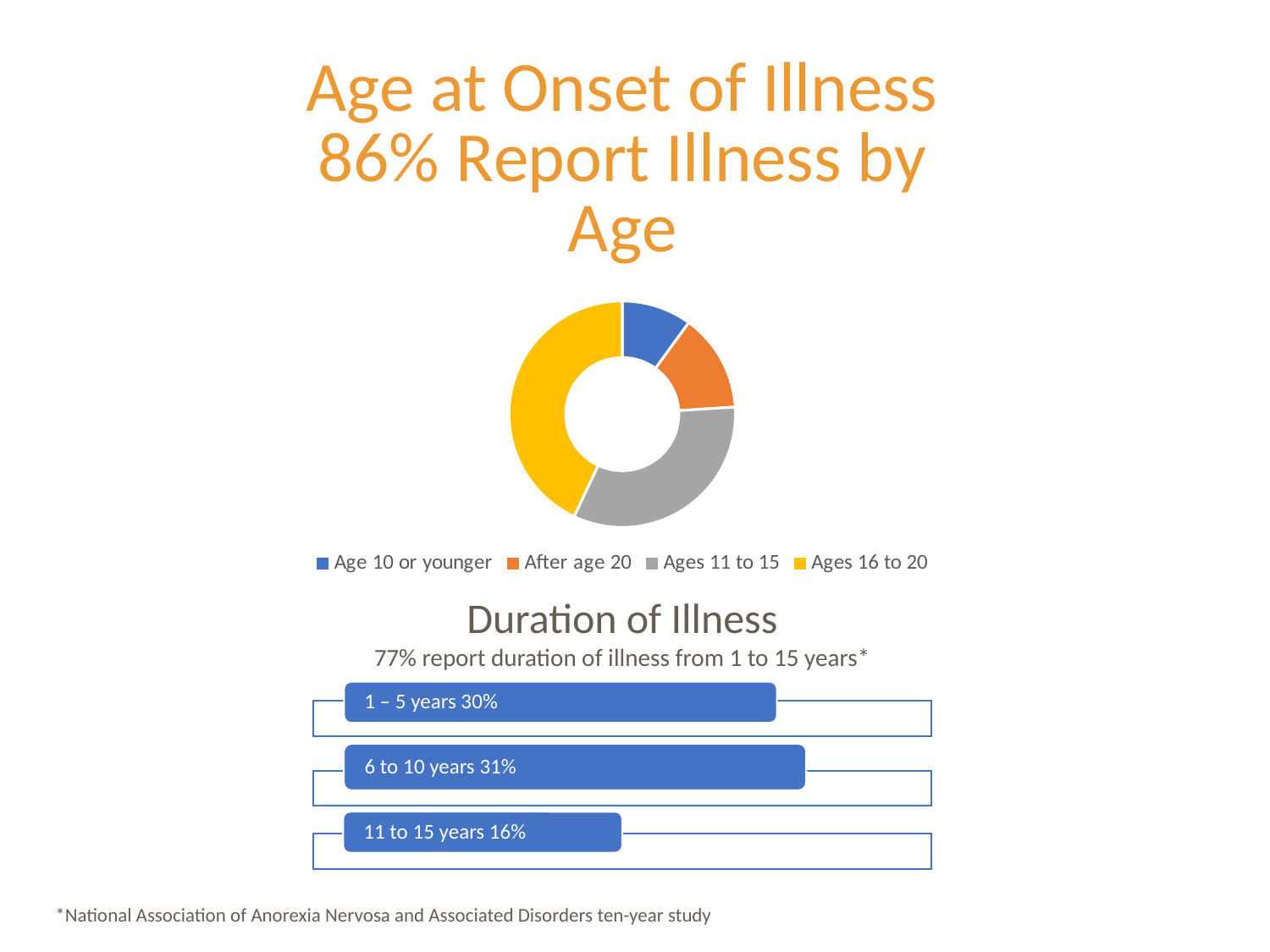
In the doughnut chart, which colour represents 'Ages 16 to 20'? Yellow How many categories does the legend of the doughnut chart list? 4 What kind of chart is shown under the title 'Age at Onset of Illness'? Doughnut chart In the doughnut chart, which slice is larger: 'Age 10 or younger' or 'After age 20'? After age 20 In the 'Duration of Illness' graphic, what percentage is shown for 11 to 15 years? 16% In the 'Duration of Illness' graphic, what percentage is shown for 6 to 10 years? 31% In the 'Duration of Illness' graphic, which duration range has the lowest percentage? 11 to 15 years In the 'Duration of Illness' graphic, what is the difference between the percentages for 6 to 10 years and 1 – 5 years? 1% In the doughnut chart, which slice is larger: 'Ages 11 to 15' or 'Age 10 or younger'? Ages 11 to 15 In the doughnut chart, which category has the smallest slice? Age 10 or younger In the doughnut chart, which category is shown in gray? Ages 11 to 15 In the 'Duration of Illness' graphic, which duration range has the highest percentage? 6 to 10 years